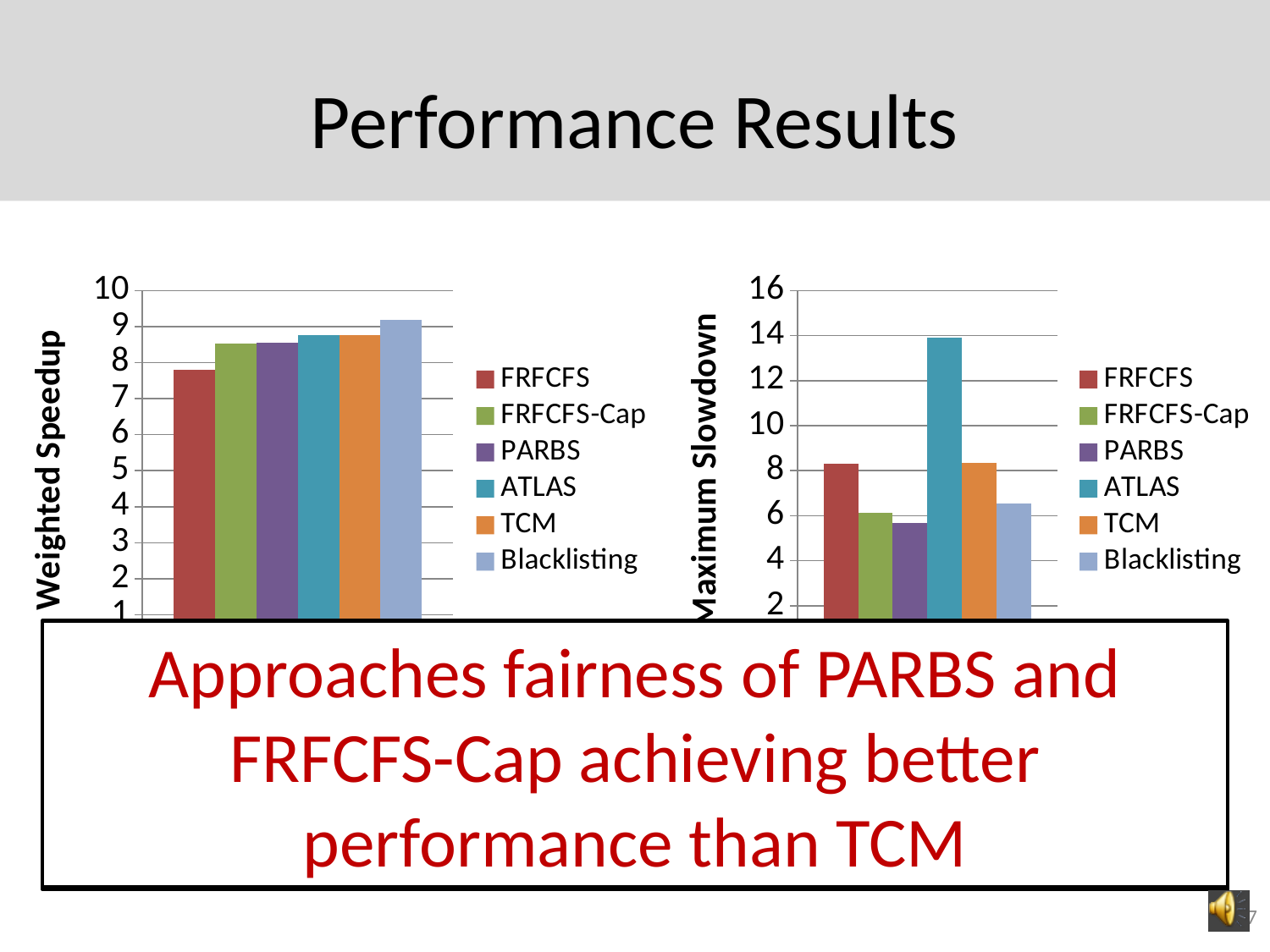
In the Maximum Slowdown chart (right), is the value for ATLAS greater or less than 12? greater In the Weighted Speedup chart (left), which series has the lowest bar? FRFCFS In the Maximum Slowdown chart (right), which is larger, the value for ATLAS or the value for TCM? ATLAS In the Maximum Slowdown chart (right), is the value for Blacklisting greater or less than 8? less In the Weighted Speedup chart (left), which series has the highest bar? Blacklisting In the Maximum Slowdown chart (right), which series has the highest bar? ATLAS In the Weighted Speedup chart (left), which is larger, the value for Blacklisting or the value for FRFCFS? Blacklisting What kind of chart is the Weighted Speedup chart (left)? bar chart What is the y-axis label of the chart on the right? Maximum Slowdown In the Weighted Speedup chart (left), is the value for FRFCFS greater or less than 8? less How many series does the legend of the Maximum Slowdown chart (right) list? 6